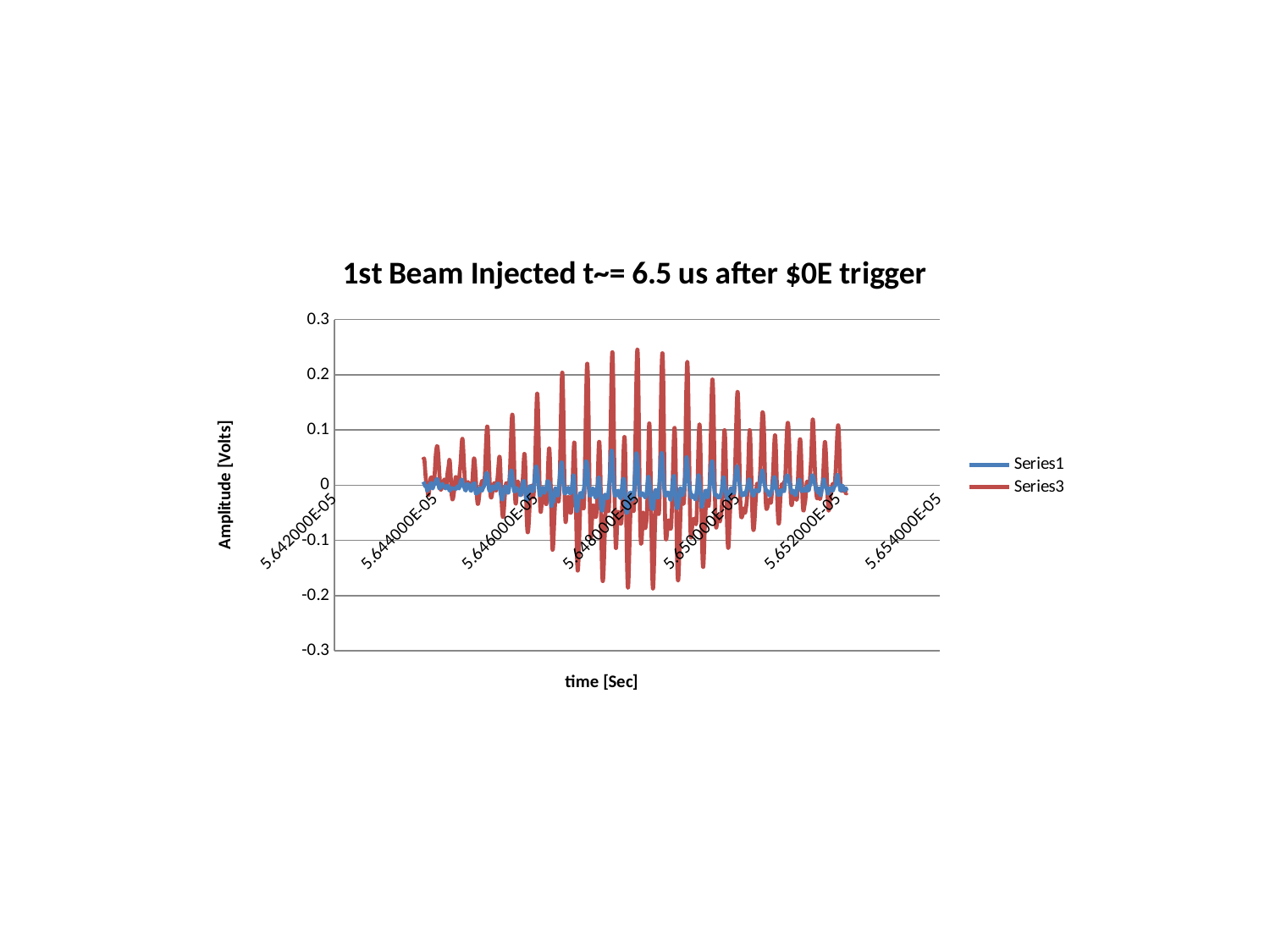
Which series has the larger swings in amplitude, Series1 or Series3? Series3 Is the lowest value reached by Series3 greater or less than -0.1? less What is the title of the chart? 1st Beam Injected t~= 6.5 us after $0E trigger Which series reaches the higher peak amplitude, Series1 or Series3? Series3 Is the highest value reached by Series3 greater or less than 0.2? greater Is the highest value reached by Series1 greater or less than 0.1? less What kind of chart is shown on the slide? line chart What is the label of the vertical axis? Amplitude [Volts] How many series does the legend list? 2